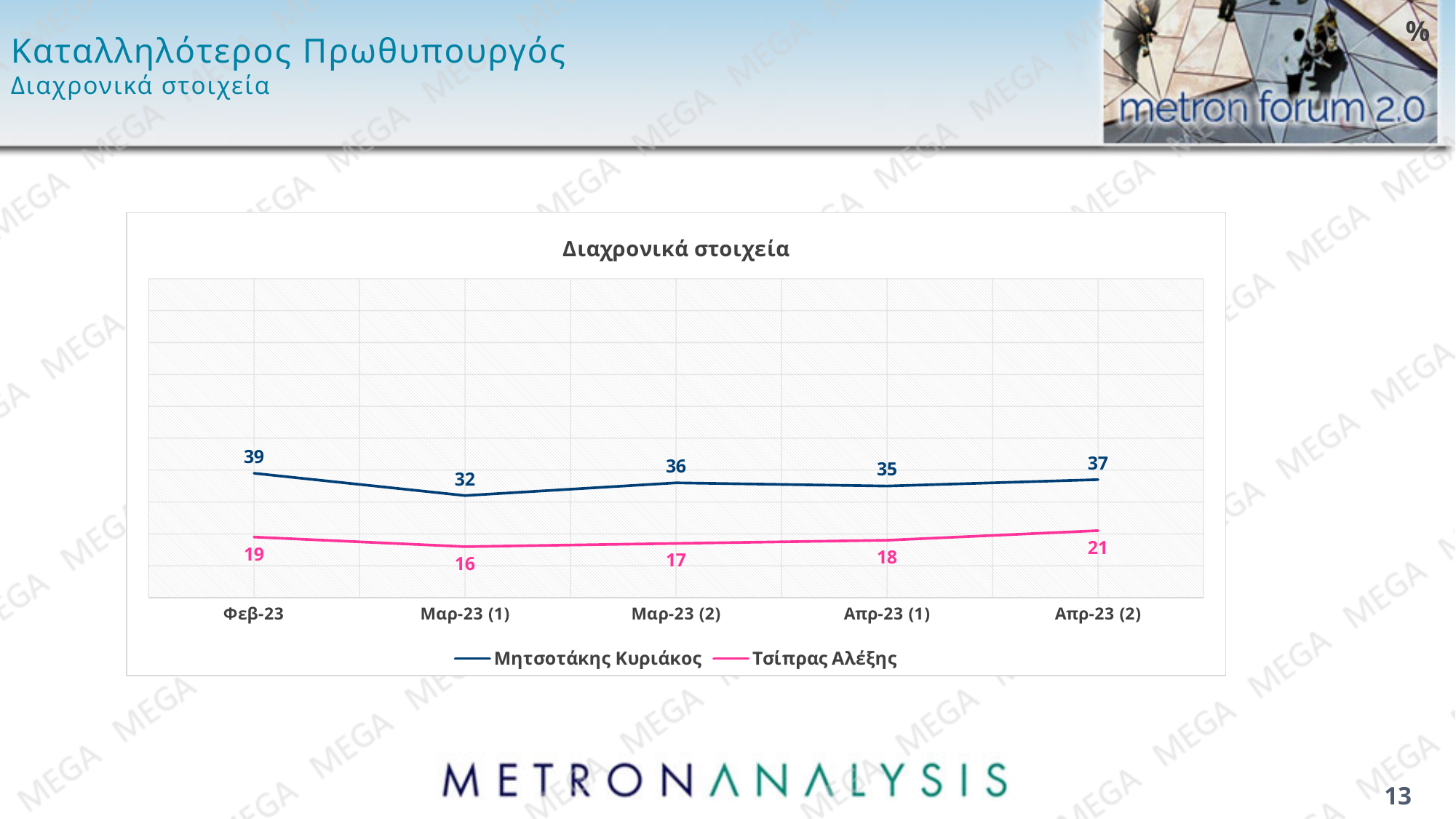
Which series has the larger value in Μαρ-23 (1), Μητσοτάκης Κυριάκος or Τσίπρας Αλέξης? Μητσοτάκης Κυριάκος What is the difference between Μητσοτάκης Κυριάκος and Τσίπρας Αλέξης in Απρ-23 (1)? 17 What is the value for Μητσοτάκης Κυριάκος in Φεβ-23? 39 Does the value for Τσίπρας Αλέξης rise or fall from Μαρ-23 (1) to Απρ-23 (2)? rise How many series does the legend list? 2 What kind of chart is shown on the slide? line chart What is the value for Τσίπρας Αλέξης in Απρ-23 (2)? 21 In which period does Μητσοτάκης Κυριάκος have his lowest value? Μαρ-23 (1) In which period does Τσίπρας Αλέξης have his highest value? Απρ-23 (2) How many time periods are shown on the x axis? 5 What is the value for Μητσοτάκης Κυριάκος in Μαρ-23 (2)? 36 What is the title of the chart? Διαχρονικά στοιχεία